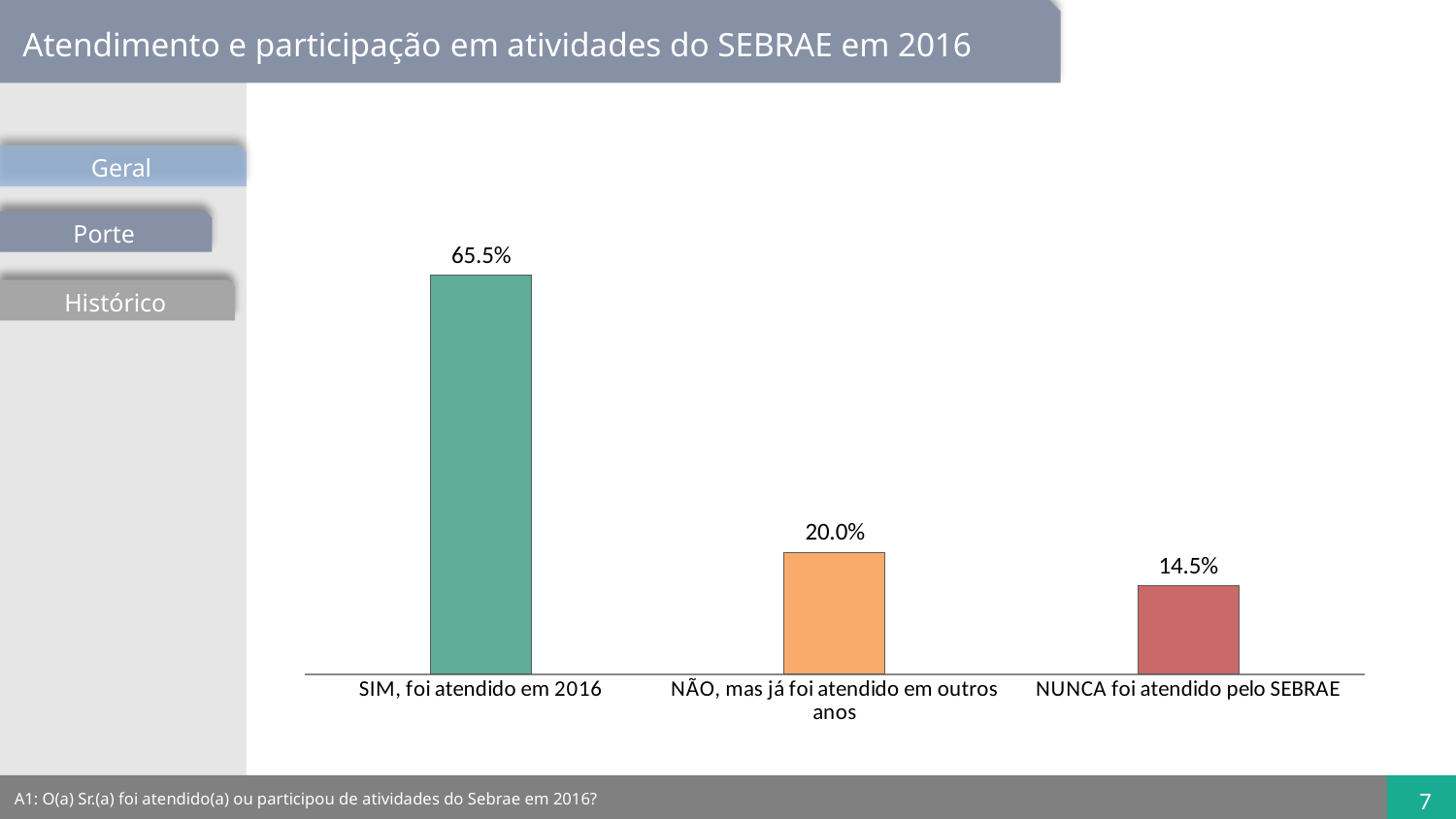
How many categories are shown in the chart? 3 What is the difference between the values for "SIM, foi atendido em 2016" and "NÃO, mas já foi atendido em outros anos"? 45.5% Do the values rise or fall from left to right across the categories? Fall What is the value for "SIM, foi atendido em 2016"? 65.5% What is the title of the slide containing the chart? Atendimento e participação em atividades do SEBRAE em 2016 Which category has the highest value? SIM, foi atendido em 2016 Which is larger: the value for "NÃO, mas já foi atendido em outros anos" or for "NUNCA foi atendido pelo SEBRAE"? NÃO, mas já foi atendido em outros anos Which category has the lowest value? NUNCA foi atendido pelo SEBRAE What kind of chart is shown on the slide? Bar chart What is the difference between the values for "NÃO, mas já foi atendido em outros anos" and "NUNCA foi atendido pelo SEBRAE"? 5.5% What is the value for "NUNCA foi atendido pelo SEBRAE"? 14.5% What is the value for "NÃO, mas já foi atendido em outros anos"? 20.0%